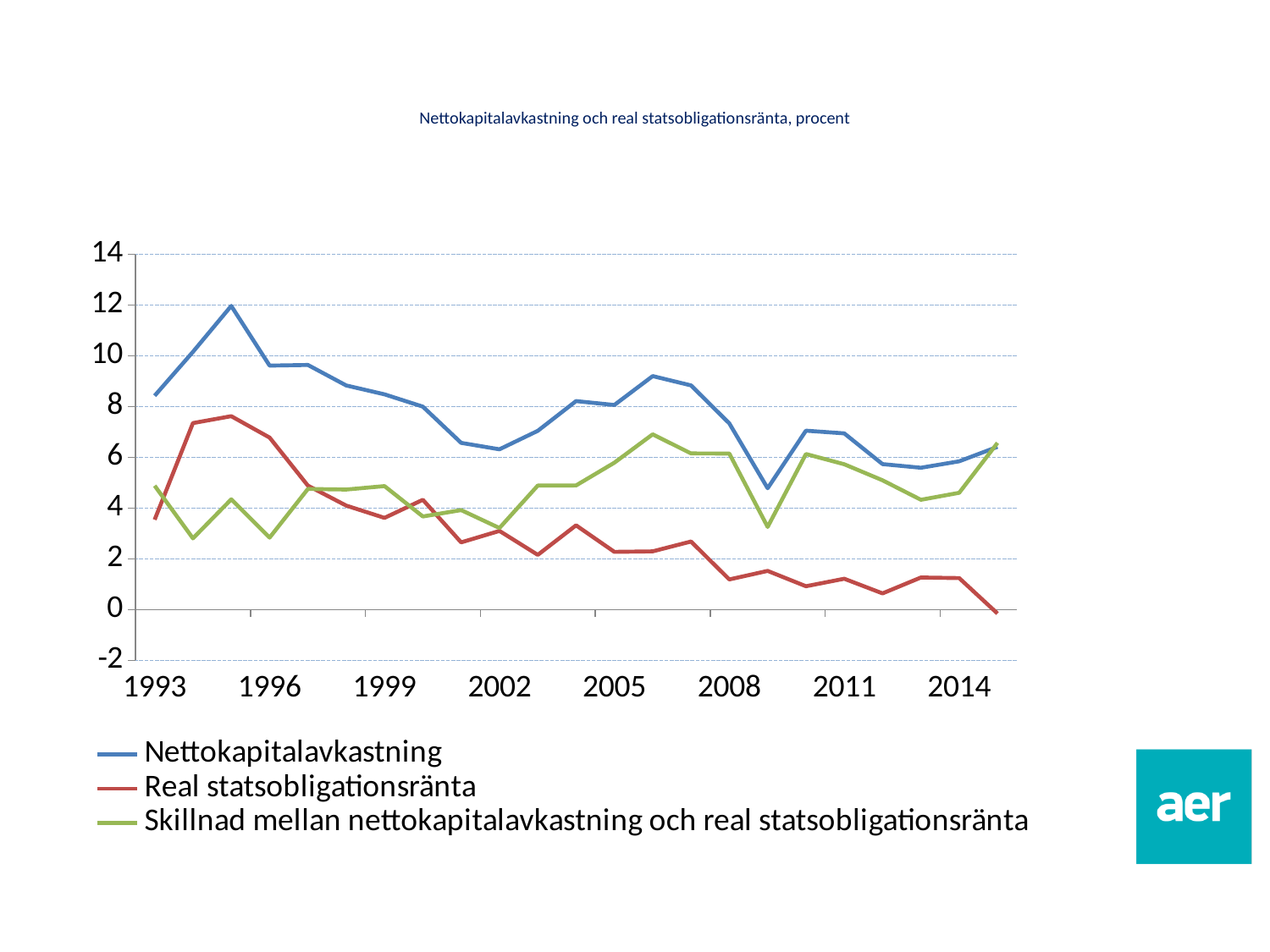
Is the value for Nettokapitalavkastning in 2009 greater or less than 6? less Is the value for Nettokapitalavkastning in 1993 greater or less than 8? greater Which series is drawn in green? Skillnad mellan nettokapitalavkastning och real statsobligationsränta In which year does Nettokapitalavkastning reach its highest value? 1995 What kind of chart is shown on the slide? line chart How many series does the legend list? 3 What is the title of the chart? Nettokapitalavkastning och real statsobligationsränta, procent Does Real statsobligationsränta generally rise or fall between 1995 and 2015? fall Is the value for Real statsobligationsränta in 2008 greater or less than 2? less In 1993, which is larger: Nettokapitalavkastning or Real statsobligationsränta? Nettokapitalavkastning In which year is Real statsobligationsränta at its lowest? 2015